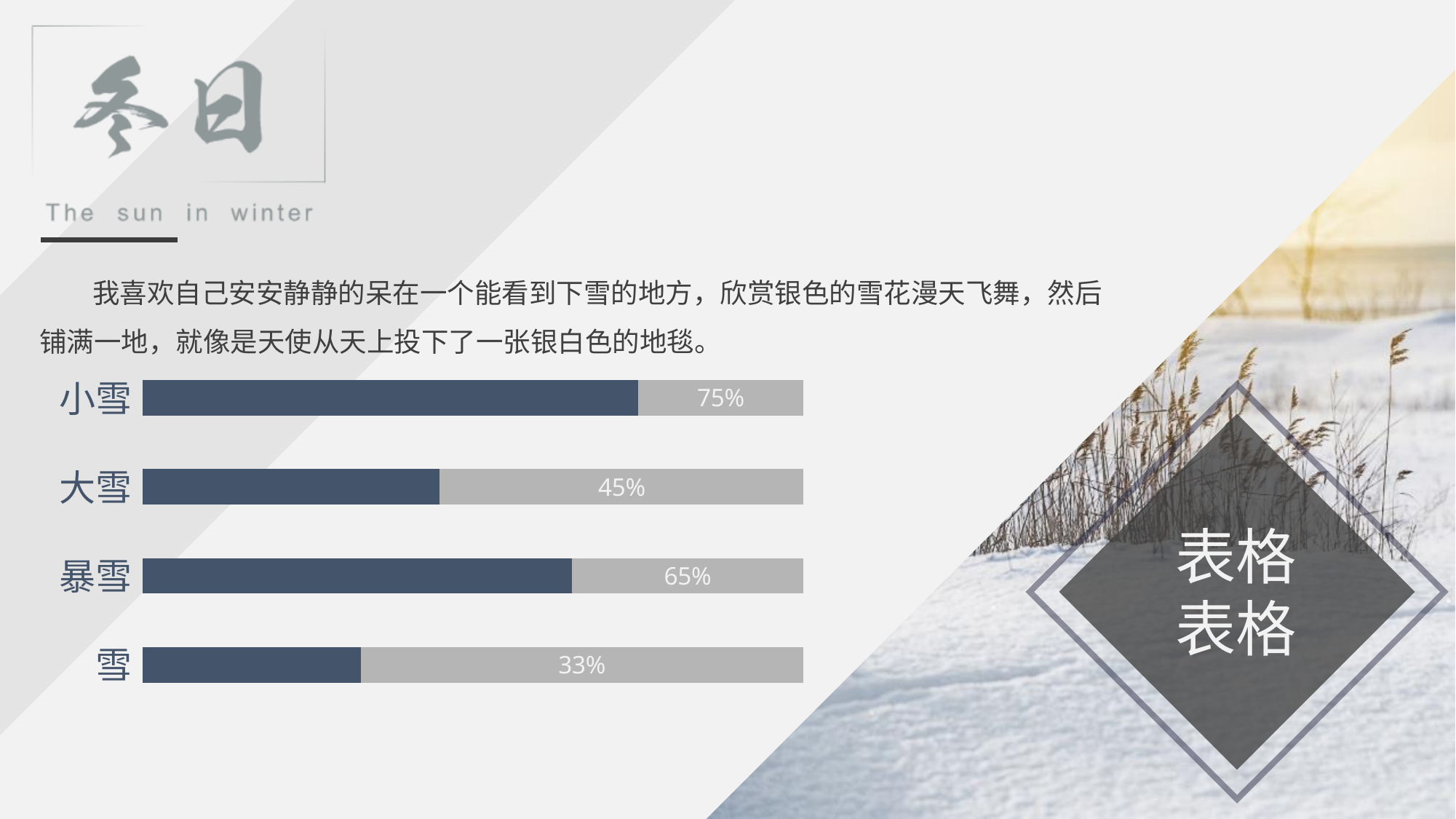
What is the difference between the values for 小雪 and 大雪? 30% What is the value for 小雪? 75% Which is larger, the value for 大雪 or the value for 暴雪? 暴雪 Which category has the lowest value? 雪 What is the value for 暴雪? 65% What colour are the filled portions of the bars? Dark blue What is the value for 雪? 33% Which category has the highest value? 小雪 What kind of chart is shown on the slide? Bar chart What is the value for 大雪? 45% What is the difference between the values for 暴雪 and 雪? 32% How many categories are shown in the chart? 4